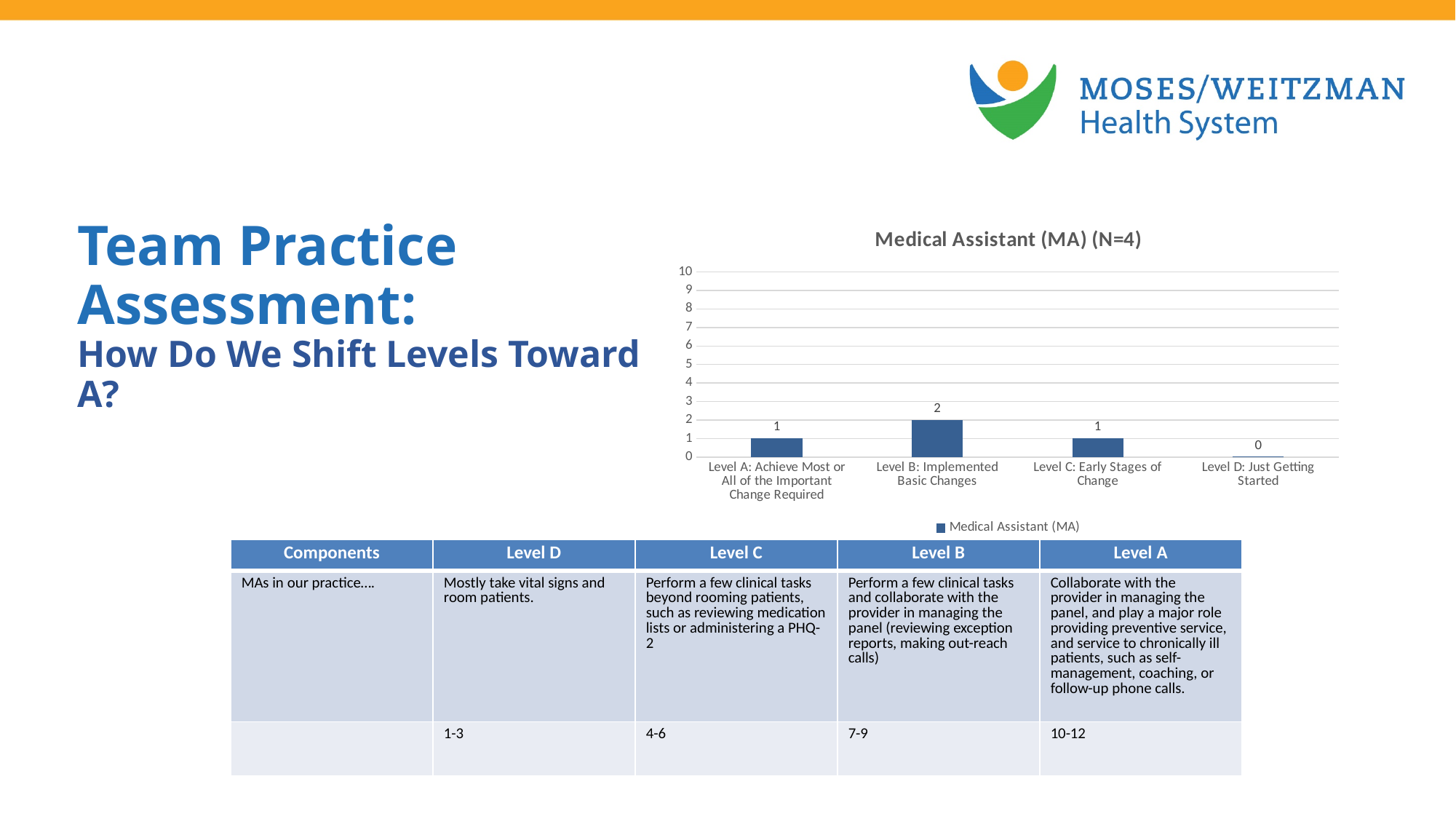
What is the value for Level B: Implemented Basic Changes? 2 What is the title of the chart? Medical Assistant (MA) (N=4) How many levels (categories) are shown on the x axis? 4 Which is larger, the value for Level B or the value for Level D? Level B What is the value for Level D: Just Getting Started? 0 What kind of chart is shown? Bar chart What is the difference between the values for Level B and Level C? 1 How many series does the legend list? 1 What is the total of all four bar values? 4 Which level has the lowest value? Level D: Just Getting Started What is the value for Level A: Achieve Most or All of the Important Change Required? 1 Which level has the highest value? Level B: Implemented Basic Changes